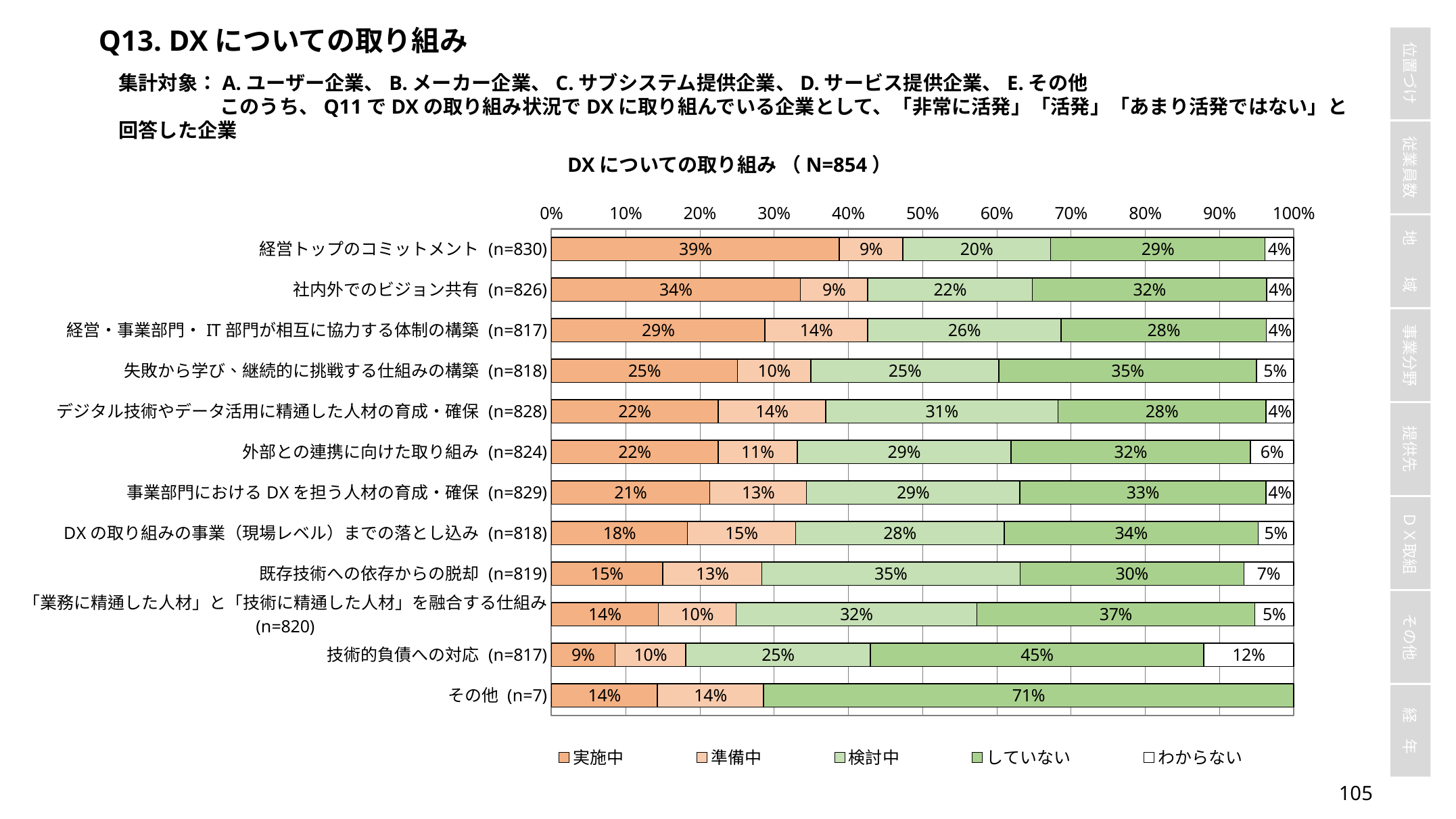
Which category has the highest わからない value? 技術的負債への対応 How many categories are shown in the chart? 12 Which category has the highest 実施中 value? 経営トップのコミットメント How many series does the legend list? 5 What is the わからない value for 技術的負債への対応? 12% What kind of chart is shown on the slide? Stacked bar chart What is the 実施中 value for 経営トップのコミットメント? 39% What is the していない value for その他 (n=7)? 71% Which has the larger 検討中 value: 既存技術への依存からの脱却 or デジタル技術やデータ活用に精通した人材の育成・確保? 既存技術への依存からの脱却 What is the difference between the 実施中 values for 経営トップのコミットメント and 社内外でのビジョン共有? 5 percentage points What is the していない value for 技術的負債への対応? 45% Which category has the lowest 実施中 value? 技術的負債への対応